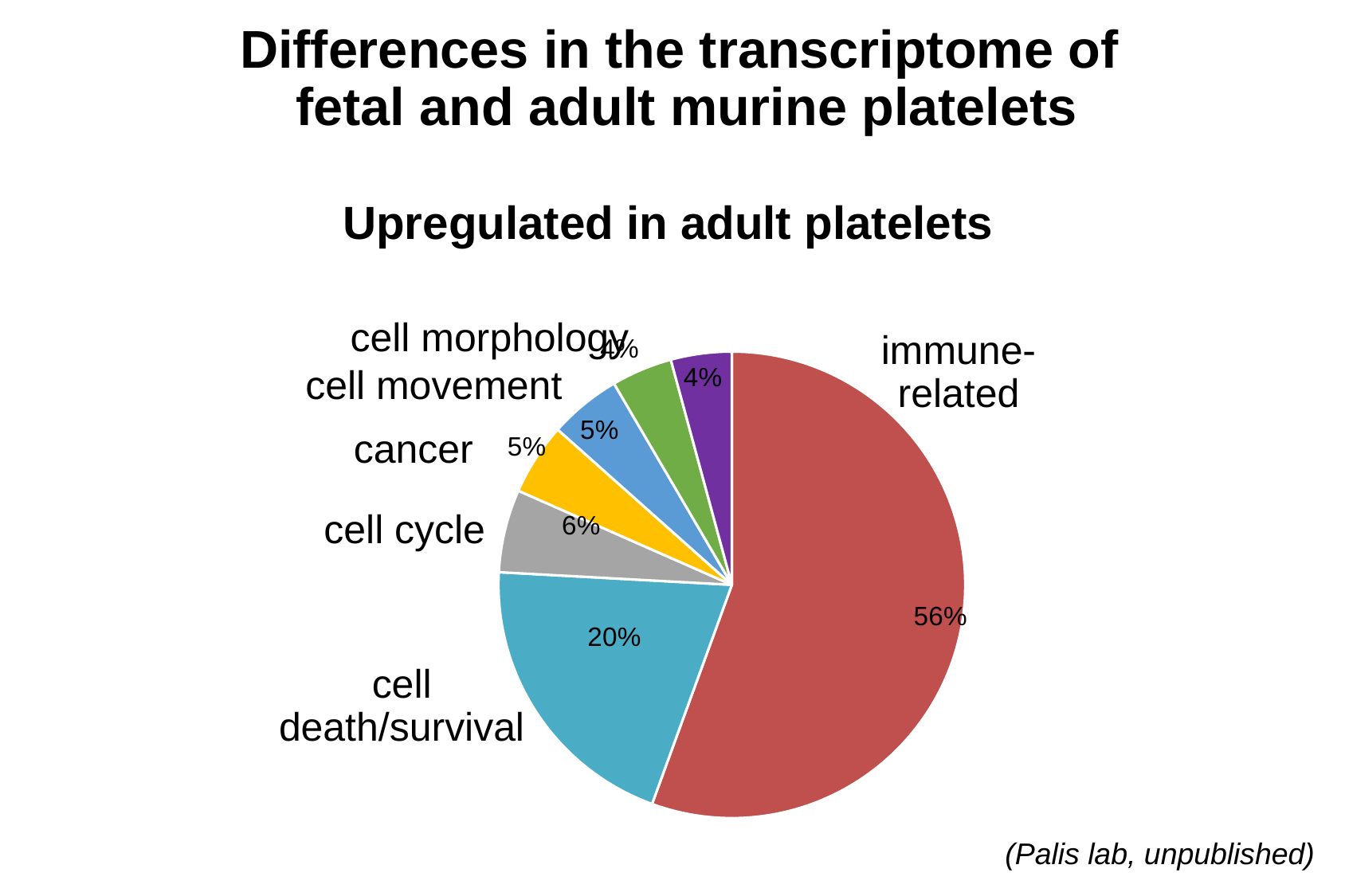
What is the value shown for cell death/survival? 20% Which category has the largest slice of the pie? immune-related What is the value shown for cancer? 5% What is the title of the chart? Upregulated in adult platelets What kind of chart is shown on the slide? pie chart What is the value shown for cell cycle? 6% What is the difference in percentage points between the immune-related slice and the cell death/survival slice? 36 percentage points What share of the pie does the immune-related slice represent? 56% Is the value for immune-related greater or less than 50%? greater How many slices does the pie chart have? 7 Which is larger, the cell death/survival slice or the cell cycle slice? cell death/survival